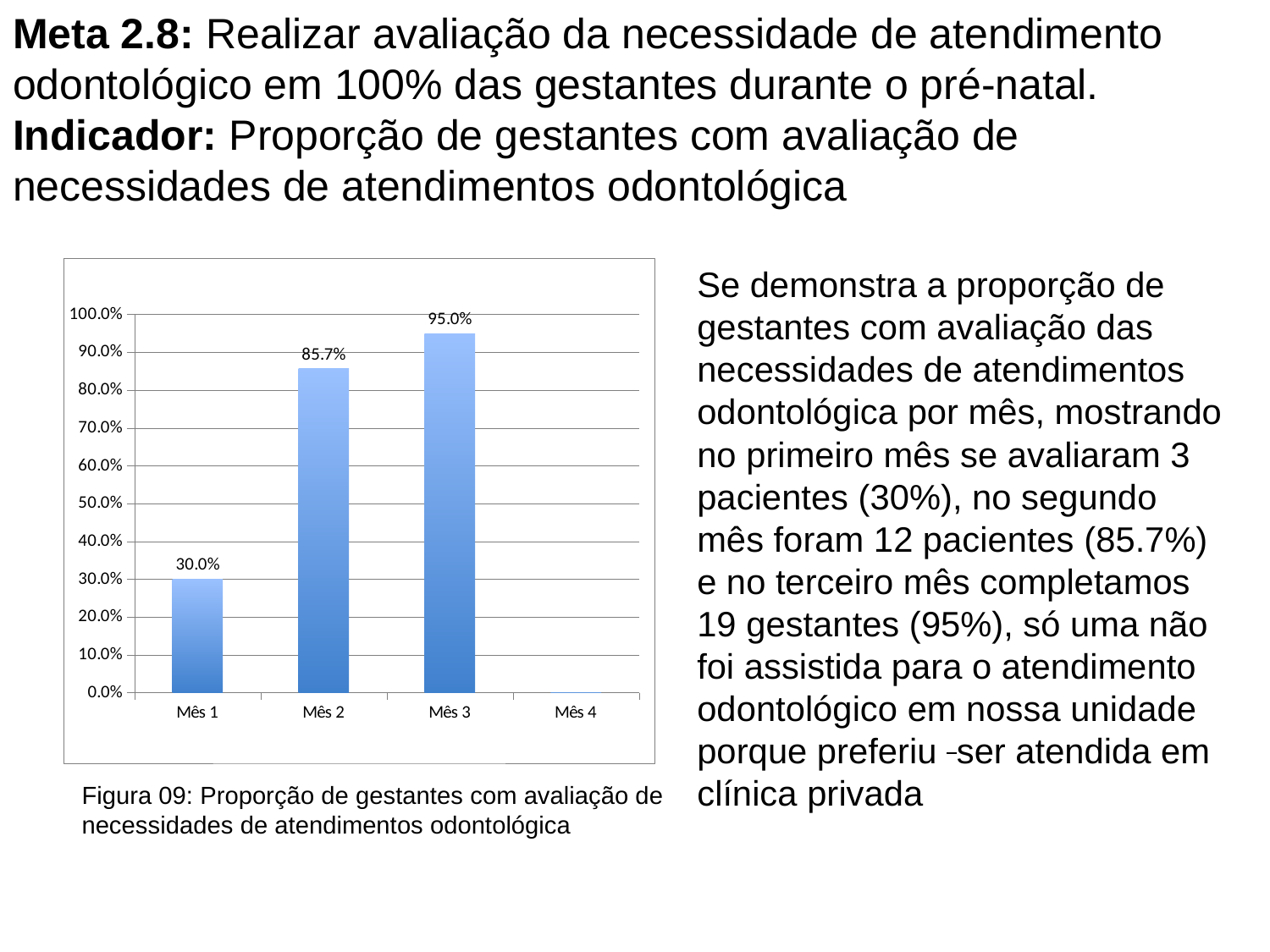
What is the value for Mês 2? 85.7% What is the value for Mês 1? 30.0% How many months are shown on the x axis? 4 What kind of chart is shown on the slide? bar chart Do the values rise or fall from Mês 1 to Mês 3? rise What figure number is given in the caption below the chart? Figura 09 What is the difference between the values for Mês 2 and Mês 1? 55.7% Is the value for Mês 3 greater or less than 90.0%? greater What is the value for Mês 3? 95.0% What is the difference between the values for Mês 3 and Mês 2? 9.3% Which is larger, the value for Mês 1 or the value for Mês 2? Mês 2 Which month has the highest value? Mês 3